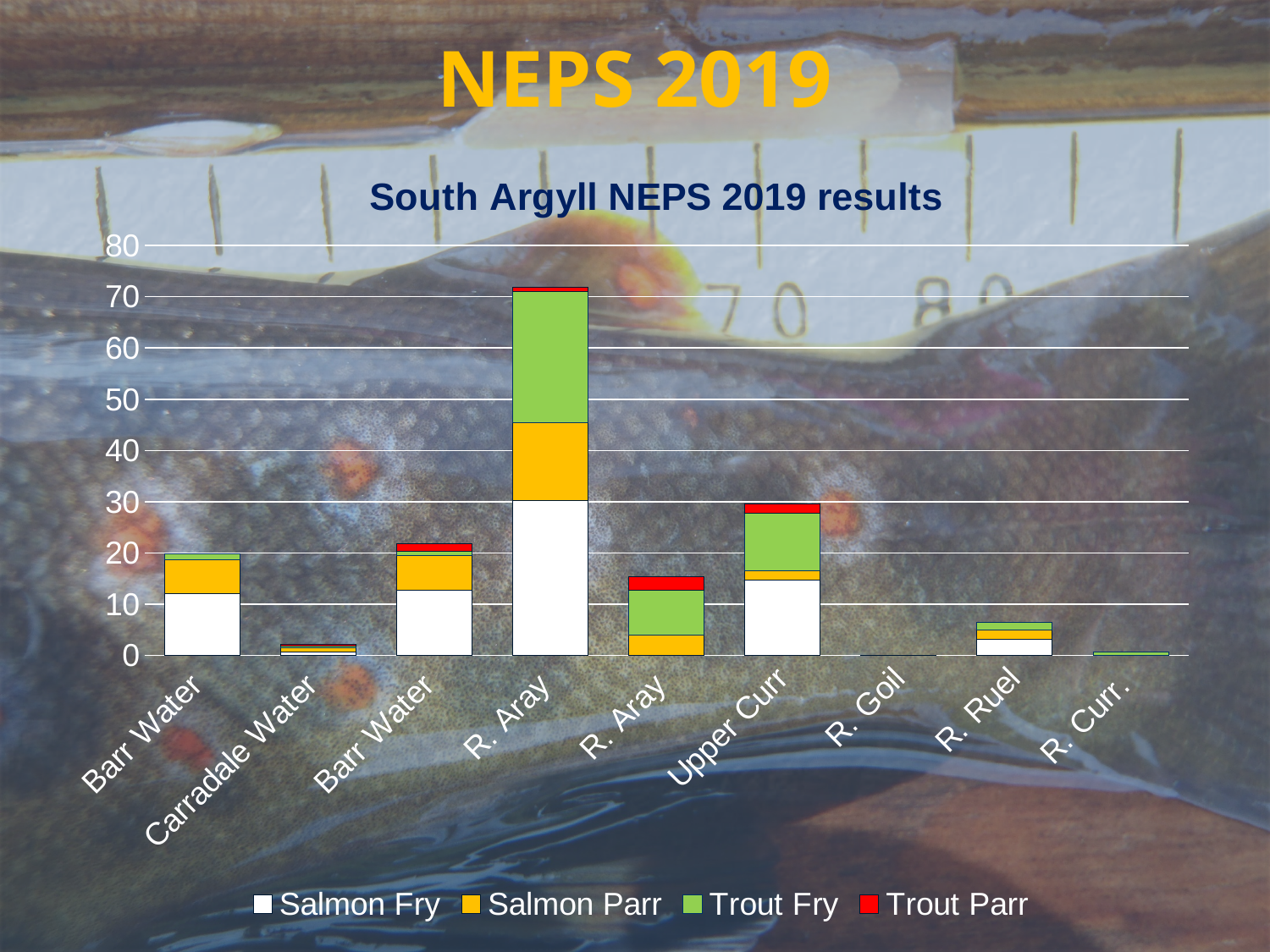
Is the total for the R. Ruel bar greater or less than 10? less Is the total for the Upper Curr bar greater or less than 20? greater How many bars (categories) are shown along the x axis? 9 What type of chart is shown on the slide? Stacked bar chart Which bar is taller, Upper Curr or the second R. Aray bar (fifth from the left)? Upper Curr Is the total for the Carradale Water bar greater or less than 10? less Which category has the tallest stacked bar? R. Aray (the first R. Aray bar) How many series does the legend list? 4 What is the title of the chart? South Argyll NEPS 2019 results Which colour represents Trout Fry in the legend? Green